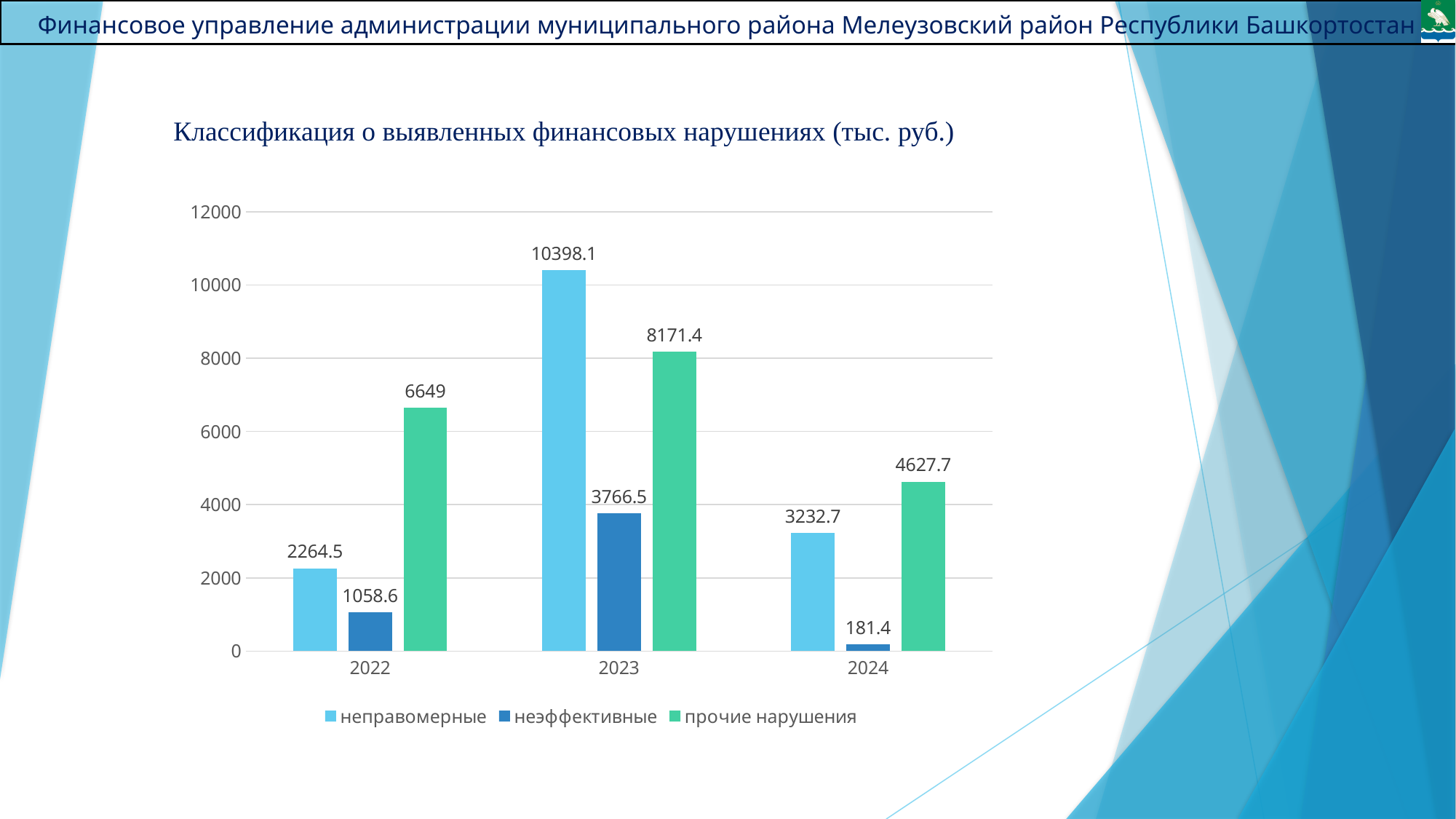
What is the value for неправомерные in 2023? 10398.1 Which is larger in 2022: неправомерные or прочие нарушения? прочие нарушения What is the value for прочие нарушения in 2022? 6649 What kind of chart is shown on the slide? bar chart How many series does the legend list? 3 How many years are shown on the x axis? 3 In which year is the value for неэффективные the lowest? 2024 What is the difference between прочие нарушения in 2023 and in 2024? 3543.7 What is the value for неэффективные in 2024? 181.4 Is the value for неправомерные in 2023 greater or less than 10000? greater What is the title of the chart? Классификация о выявленных финансовых нарушениях (тыс. руб.) In which year is the value for неправомерные the highest? 2023